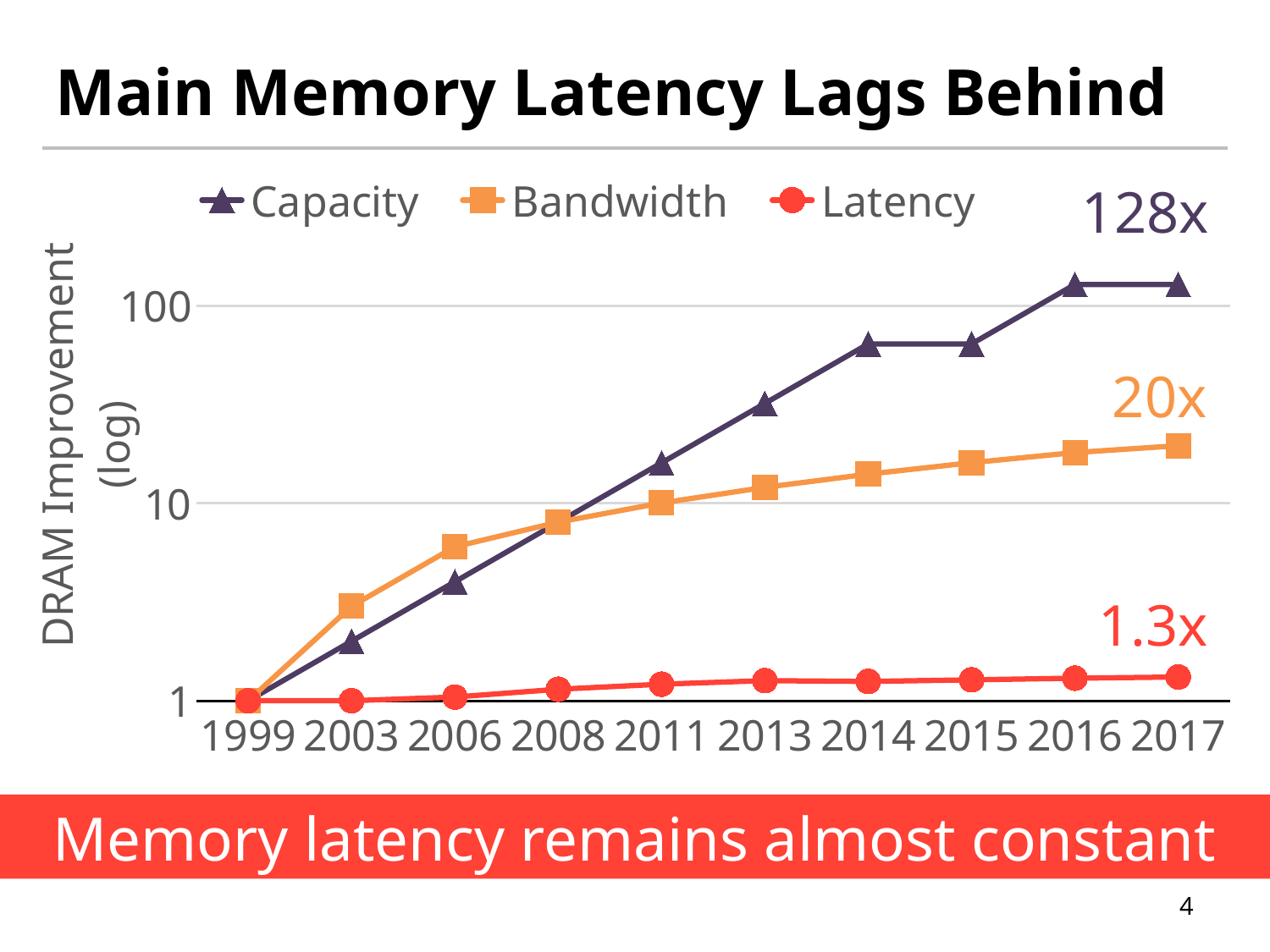
What is the DRAM latency improvement reached in 2017? 1.3x Does the Capacity series rise or fall from 1999 to 2017? rise In 2006, which is larger: the Bandwidth value or the Capacity value? Bandwidth What is the DRAM bandwidth improvement reached in 2017? 20x Is the Capacity value for 2016 greater or less than 100? greater What is the DRAM capacity improvement reached in 2017? 128x What kind of chart is shown on the slide? line chart How many series does the legend list? 3 Which series has the lowest improvement in 2017? Latency Which series has the highest improvement in 2017? Capacity What is the label on the y axis of the chart? DRAM Improvement (log) How many years are shown on the x axis? 10